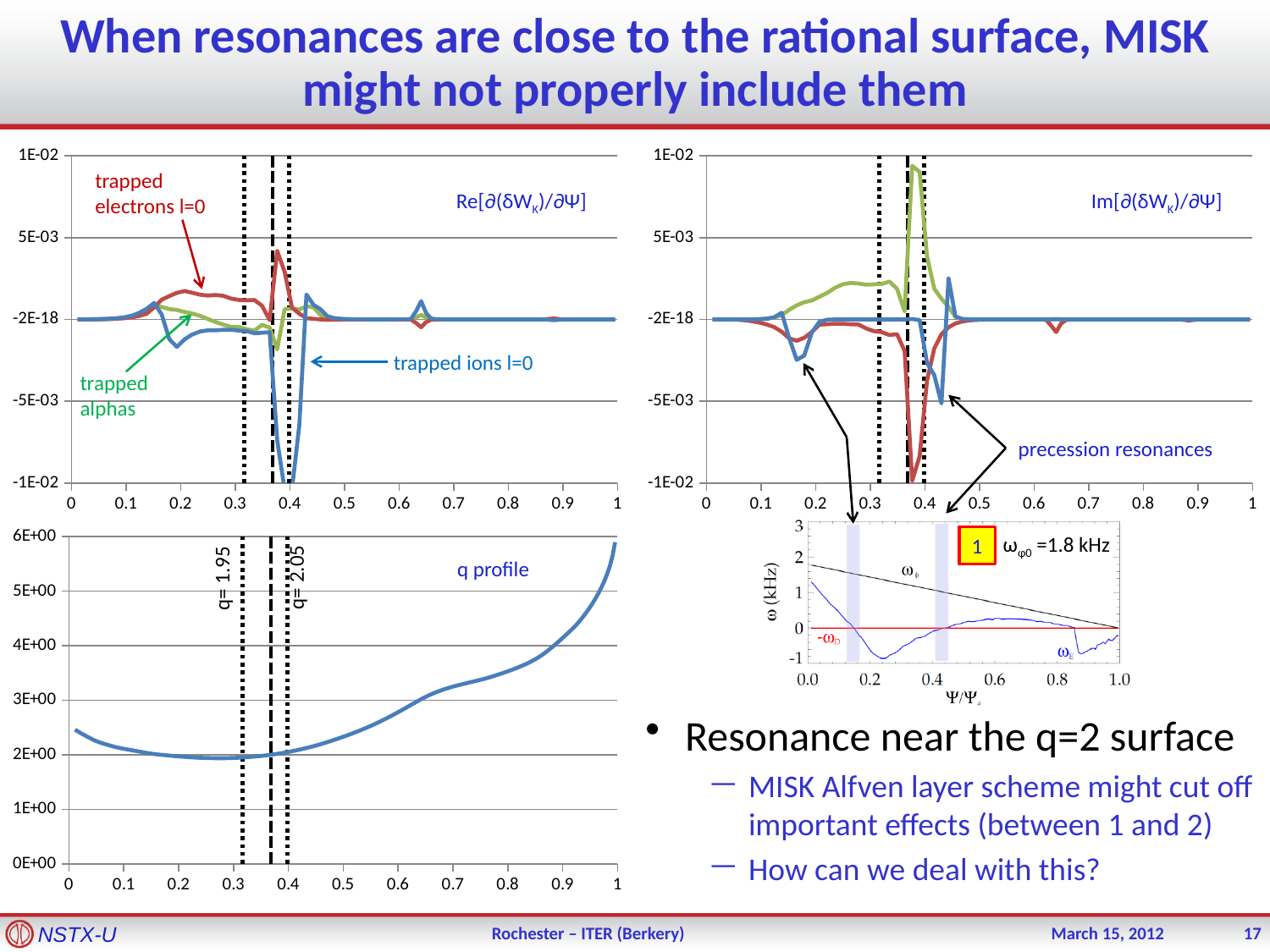
In the Re[∂(δW_K)/∂Ψ] chart at the top left, how many series are plotted? 3 In the q profile chart, is the value at x = 1 greater or less than 5E+00? greater In the Im[∂(δW_K)/∂Ψ] chart at the top right, what do the arrows pointing to the blue dips label them as? precession resonances In the Re[∂(δW_K)/∂Ψ] chart at the top left, which series is drawn in red? trapped electrons l=0 In the Re[∂(δW_K)/∂Ψ] chart at the top left, is the value of trapped ions l=0 at x = 0.4 greater or less than -5E-03? less In the q profile chart, does the curve rise or fall between x = 0.5 and x = 1? rise In the Im[∂(δW_K)/∂Ψ] chart at the top right, is the value of the blue series at its dip near x = 0.18 greater or less than -5E-03? greater In the q profile chart, what q values label the two dotted vertical lines? q= 1.95 and q= 2.05 In the small inset chart of ω (kHz) versus Ψ/Ψa, what value of ω_φ0 is printed? 1.8 kHz What kind of chart is the q profile chart at the bottom left of the slide? line chart